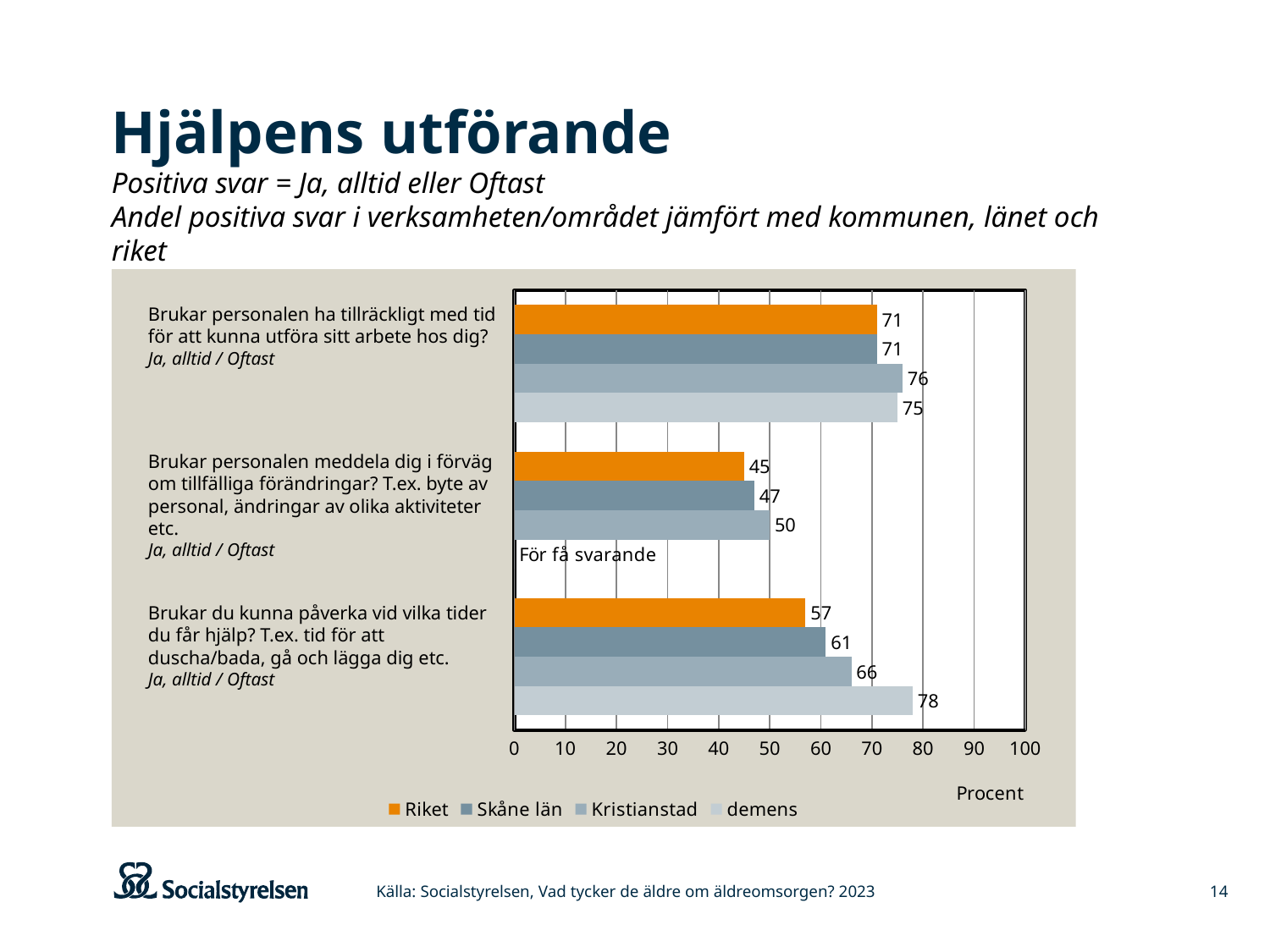
What is the value for Kristianstad on the question "Brukar du kunna påverka vid vilka tider du får hjälp?"? 66 What is the value for Riket on the question "Brukar personalen ha tillräckligt med tid för att kunna utföra sitt arbete hos dig?"? 71 What is the value for demens on the question "Brukar du kunna påverka vid vilka tider du får hjälp?"? 78 What is the difference between the demens value and the Riket value on the question "Brukar du kunna påverka vid vilka tider du får hjälp?"? 21 Which series has the highest value on the question "Brukar du kunna påverka vid vilka tider du får hjälp?"? demens What is shown for demens on the question "Brukar personalen meddela dig i förväg om tillfälliga förändringar?"? För få svarande What is the value for Skåne län on the question "Brukar personalen meddela dig i förväg om tillfälliga förändringar?"? 47 Which series has the lowest value on the question "Brukar personalen meddela dig i förväg om tillfälliga förändringar?"? Riket On the question "Brukar personalen ha tillräckligt med tid för att kunna utföra sitt arbete hos dig?", which is larger: Kristianstad or demens? Kristianstad What kind of chart is shown on the slide? Bar chart How many series does the legend list? 4 What is the label on the horizontal axis of the chart? Procent